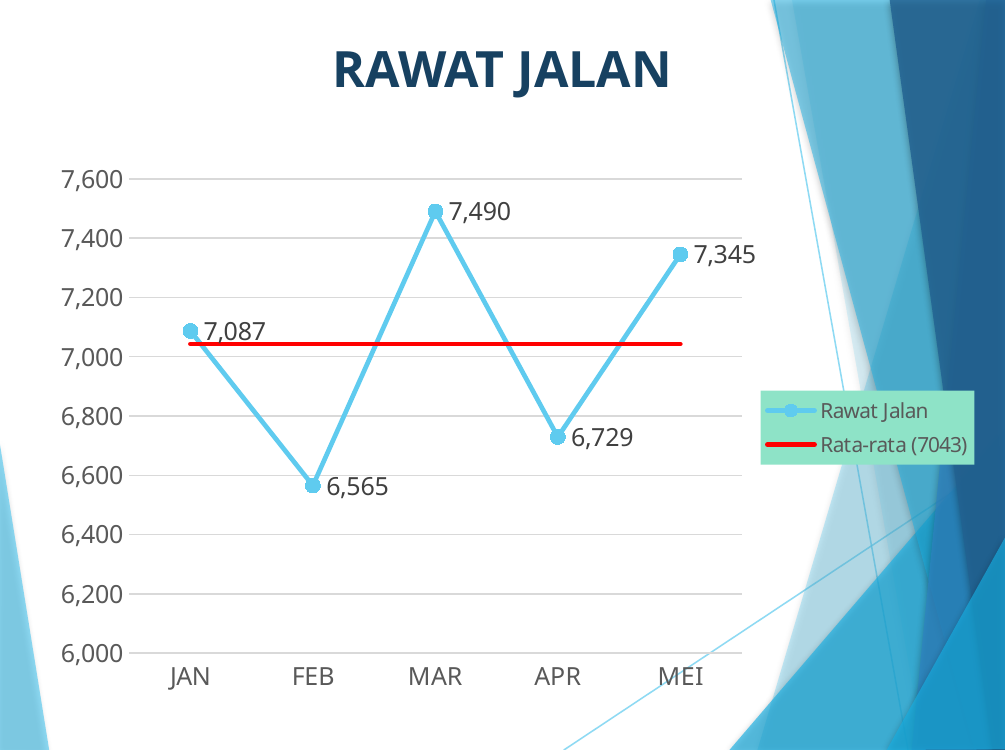
What kind of chart is shown on the slide? line chart How many series does the legend list? 2 What is the difference between the Rawat Jalan values for MAR and FEB? 925 Which month has the lowest Rawat Jalan value? FEB What average value is given in the legend for the Rata-rata line? 7043 Which month has the highest Rawat Jalan value? MAR How many months are plotted on the x axis? 5 What is the Rawat Jalan value for MEI? 7,345 What is the Rawat Jalan value for MAR? 7,490 Which is larger, the Rawat Jalan value for JAN or for APR? JAN What is the Rawat Jalan value for FEB? 6,565 Is the Rawat Jalan value for APR greater or less than 7,000? less